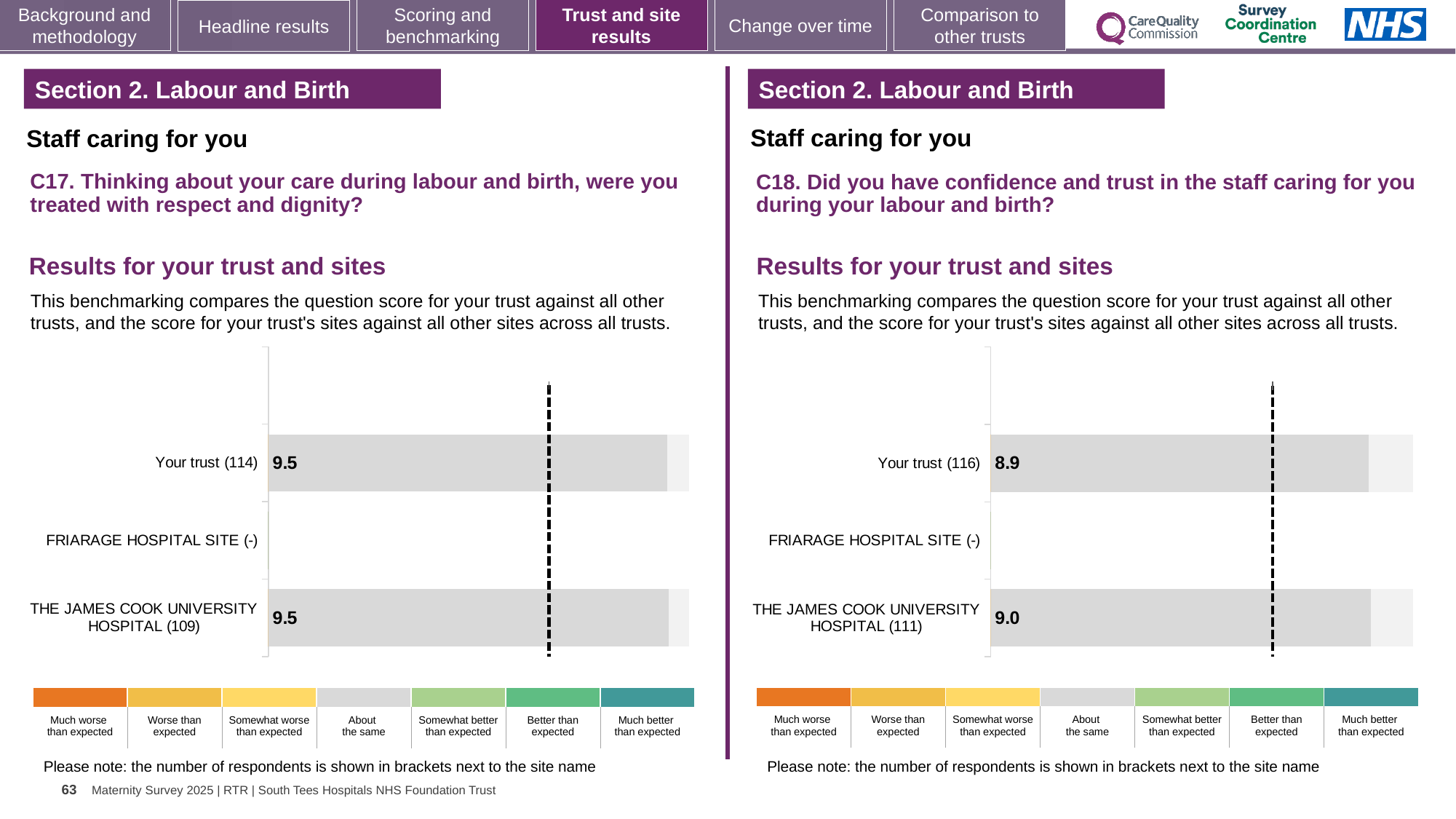
How many respondents are shown in brackets for Your trust on the right chart (C18)? 116 On the left chart (C17), how many site/trust categories are listed on the vertical axis? 3 On the left chart (C17), is the score for Your trust (114) the same as the score for THE JAMES COOK UNIVERSITY HOSPITAL (109)? Yes On the right chart (C18), what is the score for THE JAMES COOK UNIVERSITY HOSPITAL (111)? 9.0 On the left chart (C17), what is the score for Your trust (114)? 9.5 On the left chart (C17), what is the score for THE JAMES COOK UNIVERSITY HOSPITAL (109)? 9.5 On the right chart (C18), what is the score for Your trust (116)? 8.9 What type of chart is used on the left (C17) to show the results for your trust and sites? Bar chart On the left chart (C17), which category has no bar or score shown? FRIARAGE HOSPITAL SITE (-) On the right chart (C18), which has the higher score: Your trust (116) or THE JAMES COOK UNIVERSITY HOSPITAL (111)? THE JAMES COOK UNIVERSITY HOSPITAL (111) On the right chart (C18), how many site/trust categories are listed on the vertical axis? 3 On the right chart (C18), what is the difference between the score for THE JAMES COOK UNIVERSITY HOSPITAL (111) and the score for Your trust (116)? 0.1